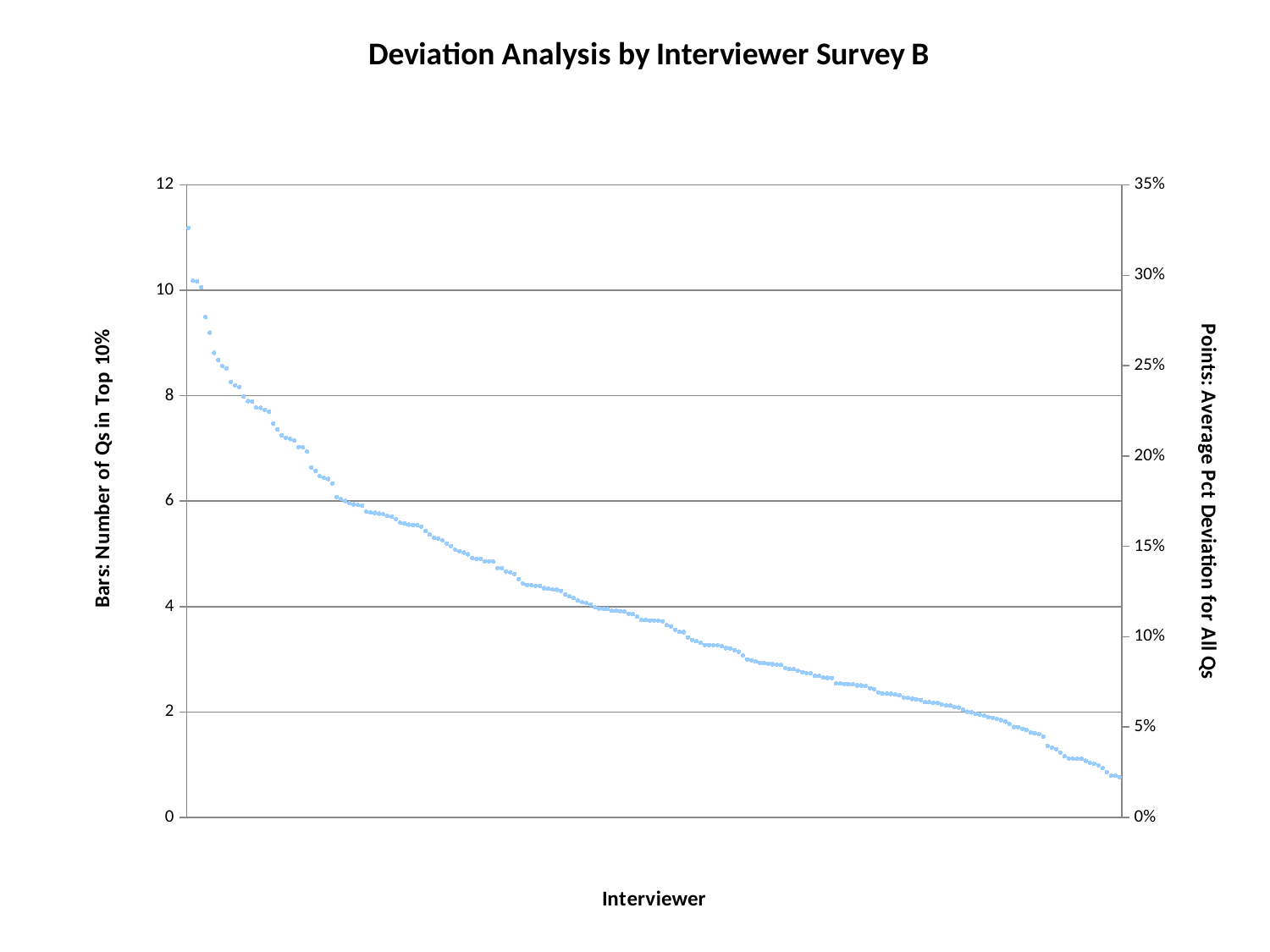
Do the plotted points rise or fall from left to right along the x axis? fall What kind of chart is shown on the slide? scatter chart What is the title of the right-hand vertical axis? Points: Average Pct Deviation for All Qs What is the title of the chart? Deviation Analysis by Interviewer Survey B